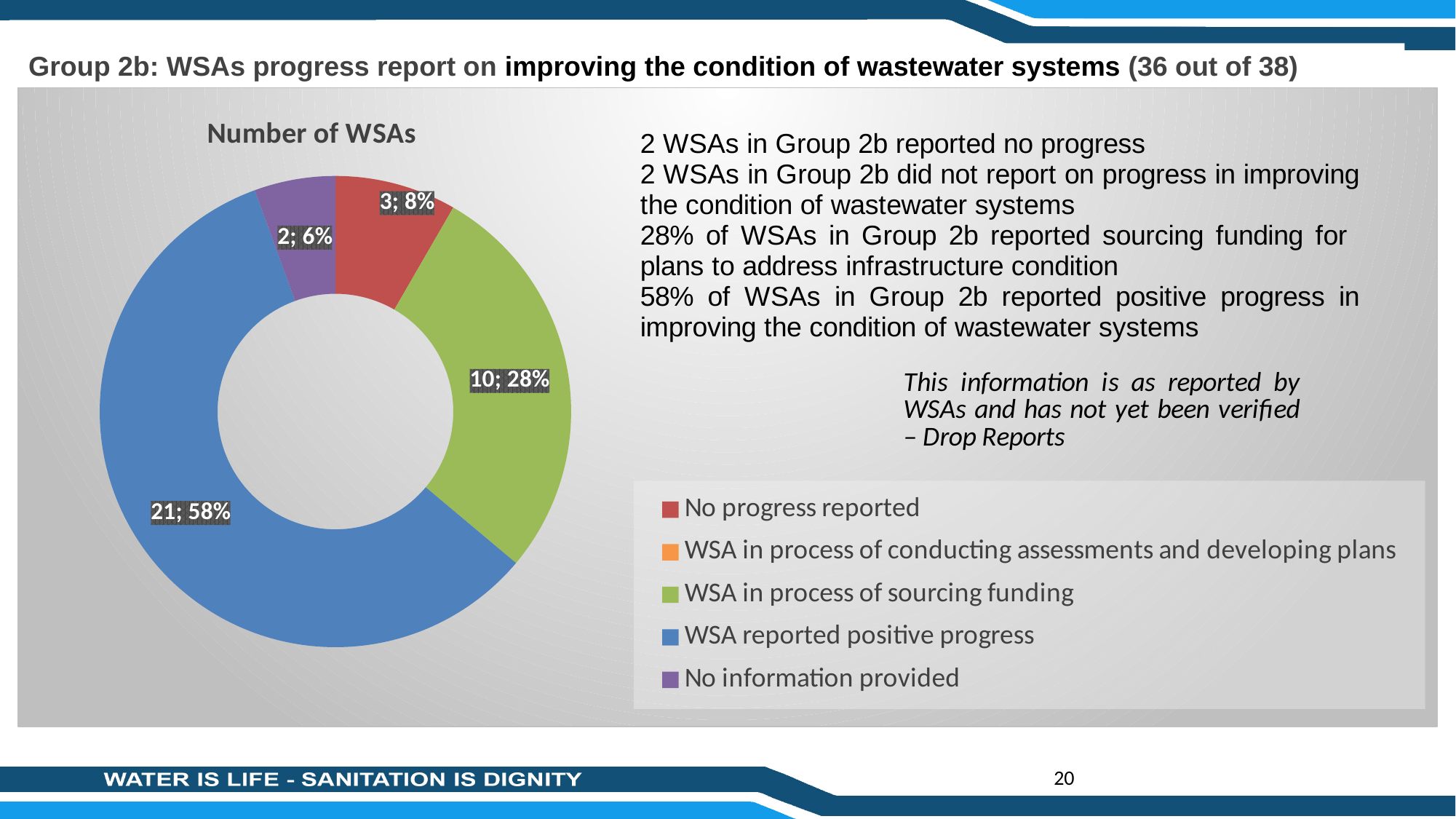
What type of chart is shown on the slide? Doughnut chart What share of the chart does 'No information provided' represent? 6% How many WSAs are shown in the 'No progress reported' slice? 3 What is the difference in number of WSAs between 'WSA reported positive progress' and 'WSA in process of sourcing funding'? 11 How many entries does the chart legend list? 5 How many WSAs reported positive progress according to the chart? 21 What colour represents 'WSA in process of sourcing funding' in the chart? Green Which labelled slice is the smallest in the chart? No information provided Which is larger: the number of WSAs with no progress reported or the number with no information provided? No progress reported What percentage of WSAs are in process of sourcing funding? 28% What is the title of the chart? Number of WSAs Which category has the largest slice in the chart? WSA reported positive progress